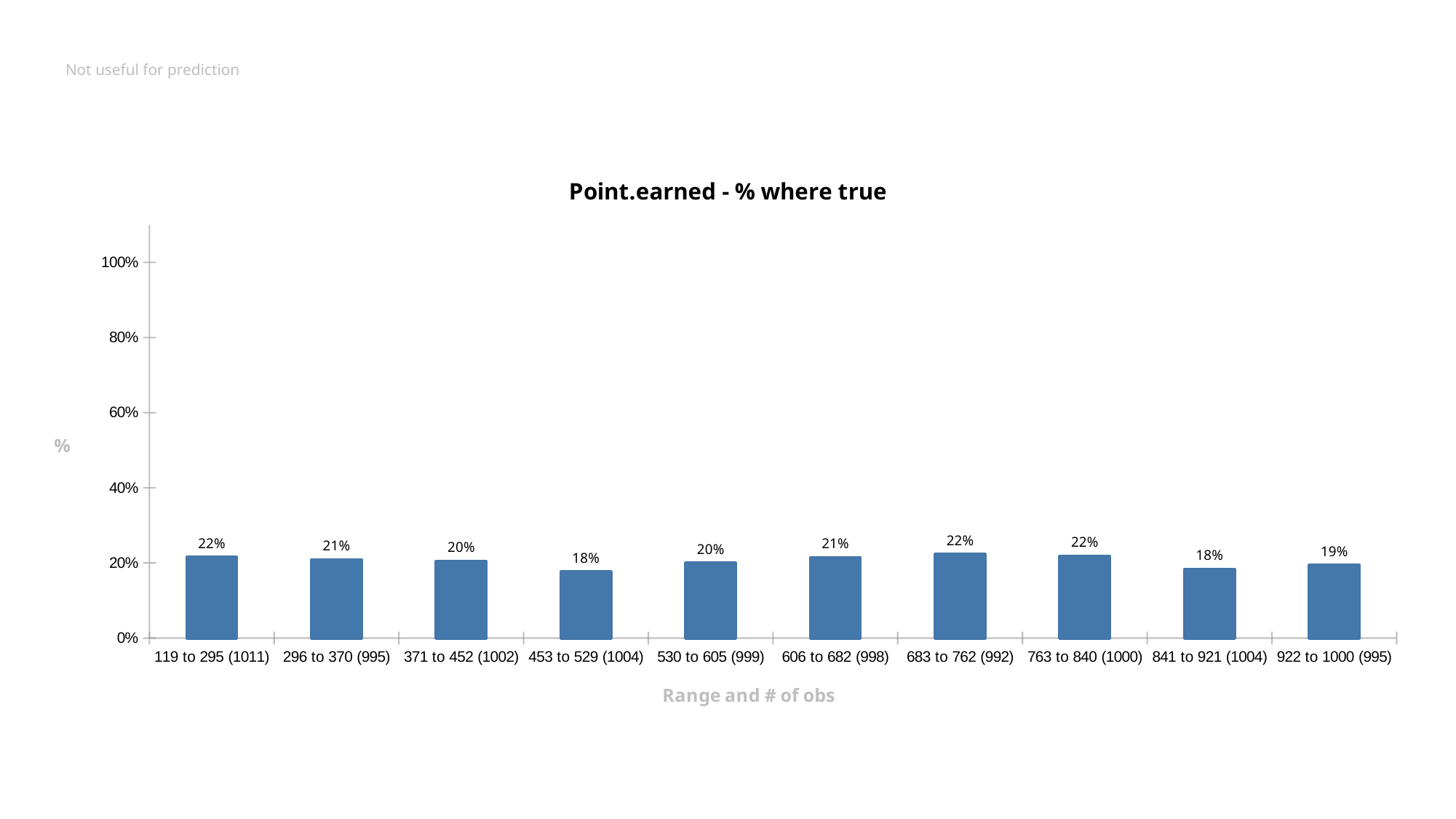
What is the value for the category "606 to 682 (998)"? 21% Which is larger, the value for "683 to 762 (992)" or the value for "841 to 921 (1004)"? 683 to 762 (992) What is the value for the category "922 to 1000 (995)"? 19% What is the value for the category "119 to 295 (1011)"? 22% What is the value for the category "453 to 529 (1004)"? 18% Is the value for "530 to 605 (999)" greater or less than 40%? less What is the difference between the value for "763 to 840 (1000)" and the value for "453 to 529 (1004)"? 4% What type of chart is shown on the slide? bar chart What is the x-axis label of the chart? Range and # of obs What is the value for the category "371 to 452 (1002)"? 20% What is the title of the chart? Point.earned - % where true How many bars (categories) are plotted in the chart? 10